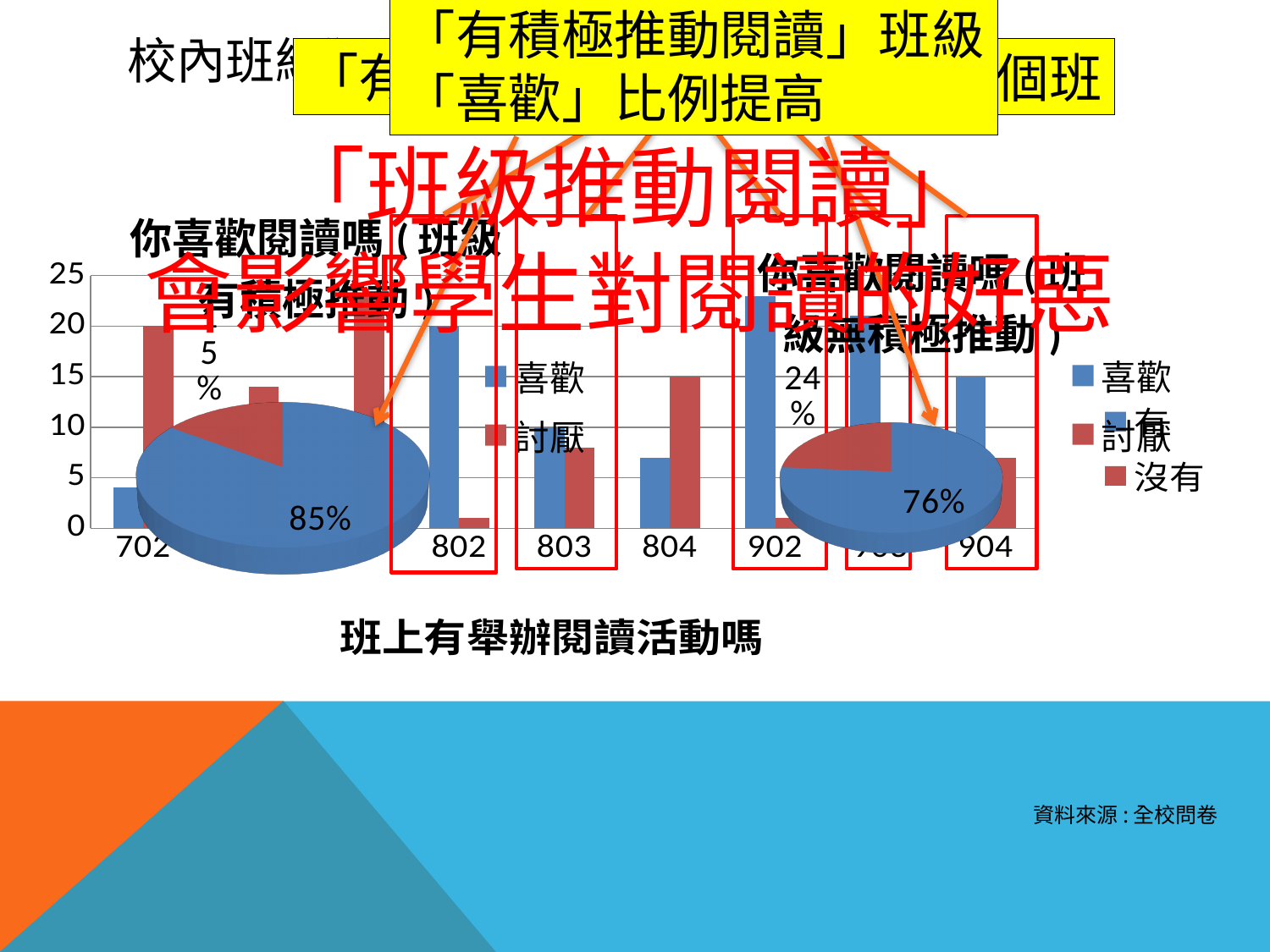
What is the difference between the 喜歡 share in the 有積極推動 pie (85%) and the 無積極推動 pie (76%)? 9% In the bar chart 班上有舉辦閱讀活動嗎, for class 702, which is larger: 有 or 沒有? 沒有 In the pie chart 你喜歡閱讀嗎(班級有積極推動), what share is labelled for 喜歡? 85% Comparing the two pie charts, which one shows the higher share for 喜歡? 你喜歡閱讀嗎(班級有積極推動) In the bar chart 班上有舉辦閱讀活動嗎, is the 有 value for class 802 greater or less than 15? greater In the pie chart 你喜歡閱讀嗎(班級無積極推動), what share is labelled for 喜歡? 76% In the bar chart 班上有舉辦閱讀活動嗎, is the 沒有 value for class 702 greater or less than 15? greater In the bar chart 班上有舉辦閱讀活動嗎, how many series does the legend list? 2 In the pie chart 你喜歡閱讀嗎(班級無積極推動), what share is labelled for 討厭? 24% In the bar chart 班上有舉辦閱讀活動嗎, is the 沒有 value for class 804 greater or less than 10? greater What data source is cited at the bottom of the slide? 全校問卷 What kind of chart is 班上有舉辦閱讀活動嗎? bar chart